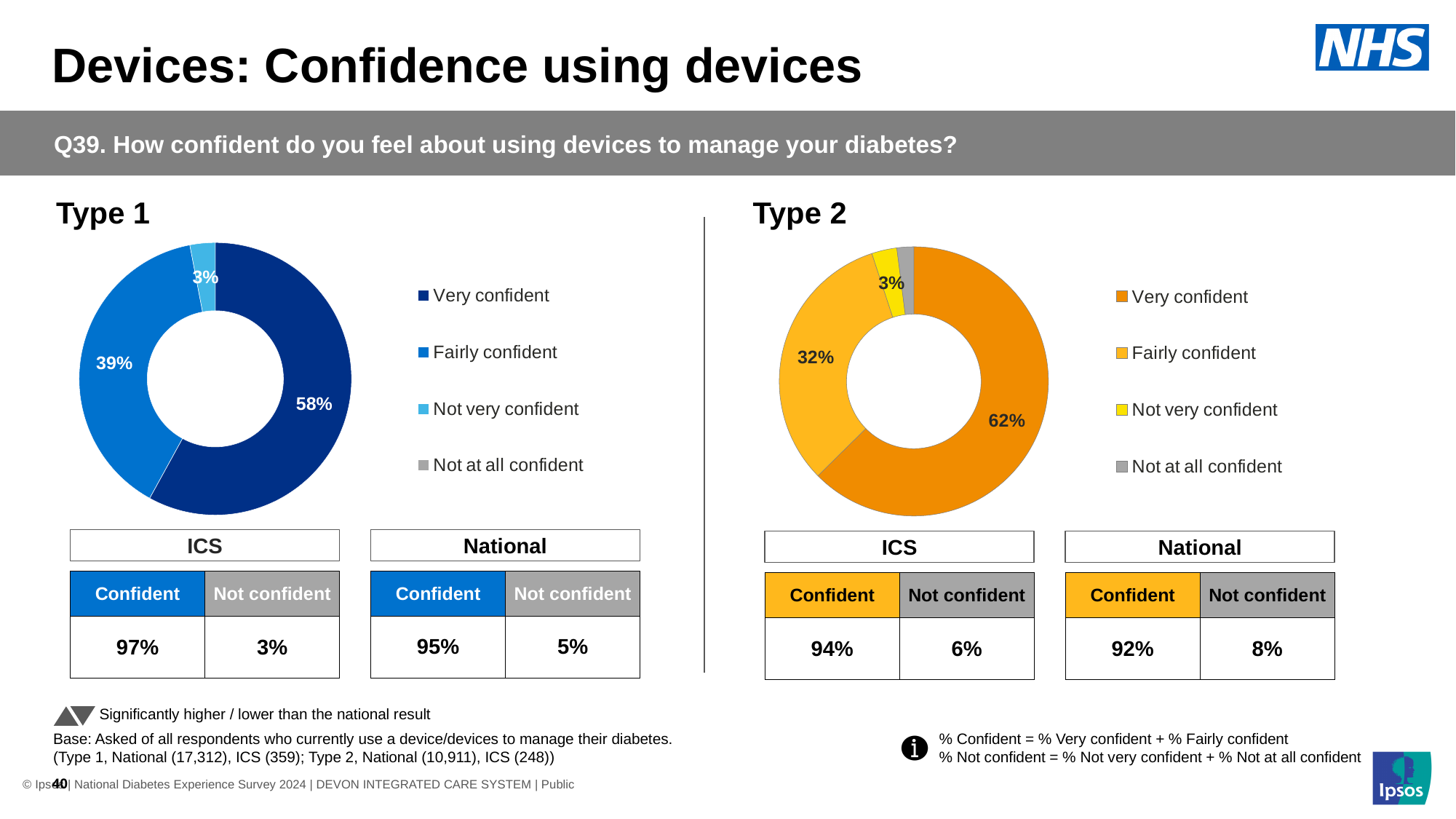
Which chart shows a larger share of very confident respondents, Type 1 or Type 2? Type 2 In the Type 1 chart, what percentage of respondents are fairly confident? 39% How many response categories does the legend of the Type 1 chart list? 4 In the Type 1 chart, what percentage of respondents are very confident using devices? 58% In the Type 2 chart, what is the difference in percentage points between very confident and fairly confident? 30 percentage points What kind of chart is used to show the Type 2 results? Pie (donut) chart In the Type 1 chart, which response category has the largest share? Very confident In the Type 2 chart, what percentage of respondents are very confident? 62% In the Type 2 chart, which response category has the largest share? Very confident In the Type 2 chart, what percentage of respondents are not very confident? 3% In the Type 2 chart, what percentage of respondents are fairly confident? 32% In the Type 1 chart, what is the difference in percentage points between very confident and fairly confident? 19 percentage points